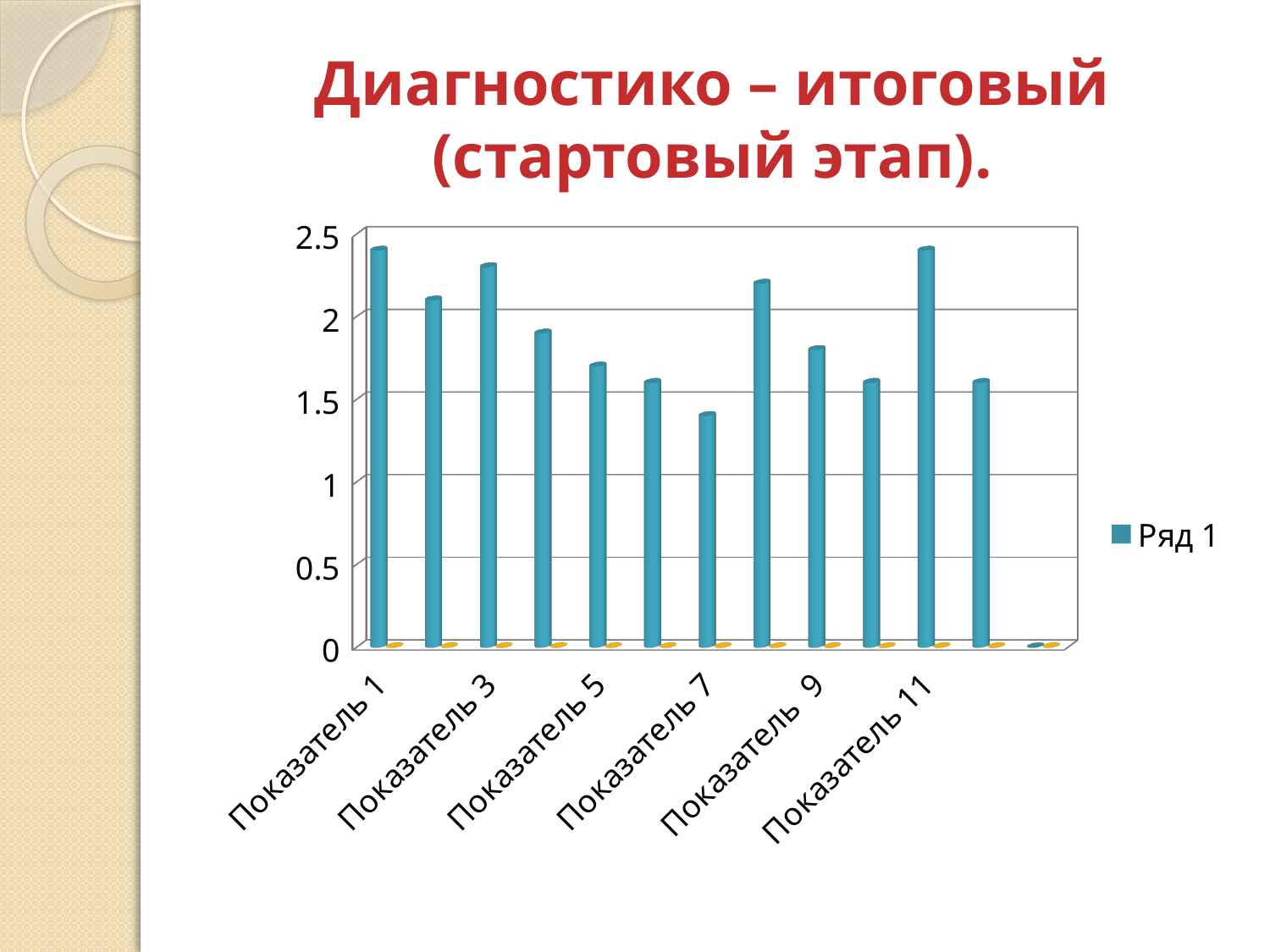
What is the name of the series in the legend? Ряд 1 Is the value for Показатель 1 greater or less than 2? greater Which is larger, the value for Показатель 9 or Показатель 11? Показатель 11 Is the value for Показатель 7 greater or less than 1.5? less Is the value for Показатель 3 greater or less than 2? greater How many series does the legend list? 1 What is the title of the slide containing the chart? Диагностико – итоговый (стартовый этап). Which is larger, the value for Показатель 1 or Показатель 7? Показатель 1 What kind of chart is shown on the slide? bar chart Which is larger, the value for Показатель 3 or Показатель 5? Показатель 3